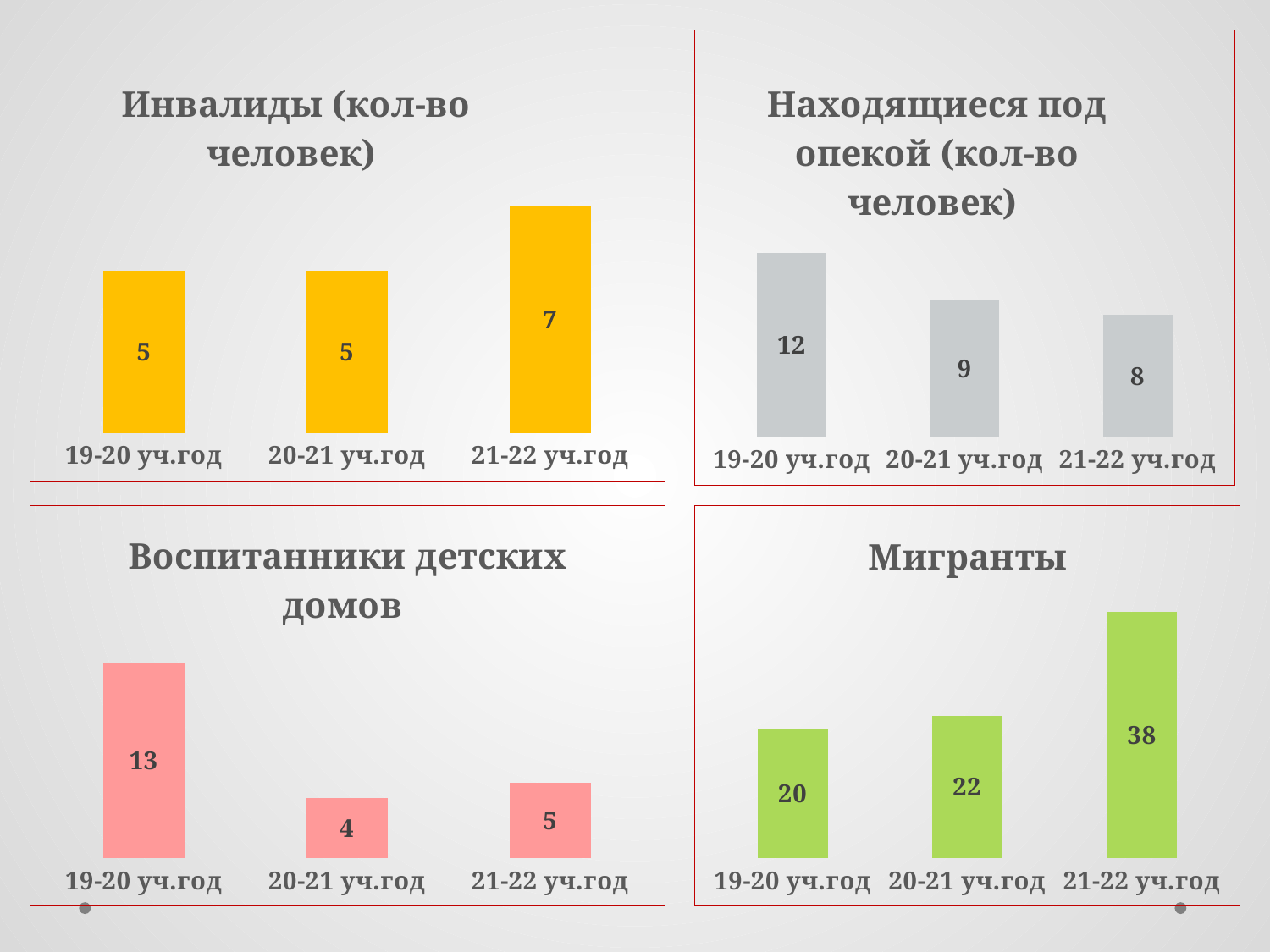
In the chart titled "Находящиеся под опекой (кол-во человек)", what is the value for 19-20 уч.год? 12 In the chart titled "Мигранты", what is the difference between the values for 21-22 уч.год and 20-21 уч.год? 16 In the chart titled "Находящиеся под опекой (кол-во человек)", which is larger: the value for 19-20 уч.год or 20-21 уч.год? 19-20 уч.год In the chart titled "Воспитанники детских домов", what is the value for 20-21 уч.год? 4 What kind of chart is the chart titled "Мигранты"? Bar chart In the chart titled "Мигранты", which year has the highest value? 21-22 уч.год In the chart titled "Воспитанники детских домов", what is the difference between the values for 19-20 уч.год and 21-22 уч.год? 8 In the chart titled "Инвалиды (кол-во человек)", what is the value for 21-22 уч.год? 7 In the chart titled "Мигранты", what is the value for 21-22 уч.год? 38 In the chart titled "Находящиеся под опекой (кол-во человек)", do the values rise or fall from 19-20 уч.год to 21-22 уч.год? Fall How many categories are shown in the chart titled "Инвалиды (кол-во человек)"? 3 In the chart titled "Находящиеся под опекой (кол-во человек)", which year has the lowest value? 21-22 уч.год